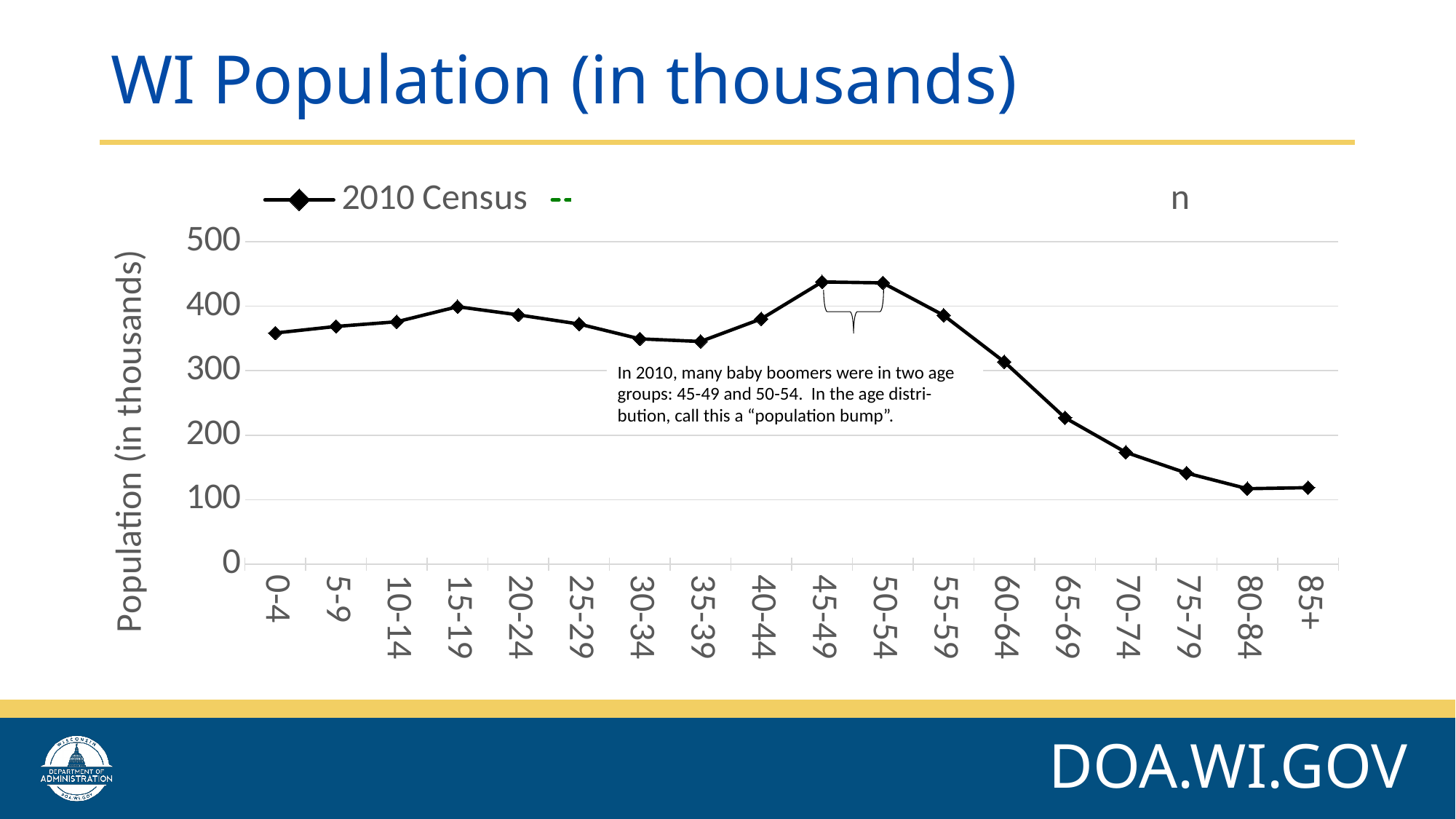
How many age groups are plotted along the x axis? 18 Which age group has the larger value, 60-64 or 70-74? 60-64 Is the value for the 0-4 age group greater or less than 300? greater What is the title of the chart? WI Population (in thousands) What kind of chart is shown on the slide? line chart Do the values rise or fall from the 55-59 age group to the 80-84 age group? fall What is the label of the y axis? Population (in thousands) Is the value for the 80-84 age group greater or less than 200? less Is the value for the 45-49 age group greater or less than 400? greater Which age group has the larger value, 15-19 or 35-39? 15-19 Do the values rise or fall from the 35-39 age group to the 45-49 age group? rise